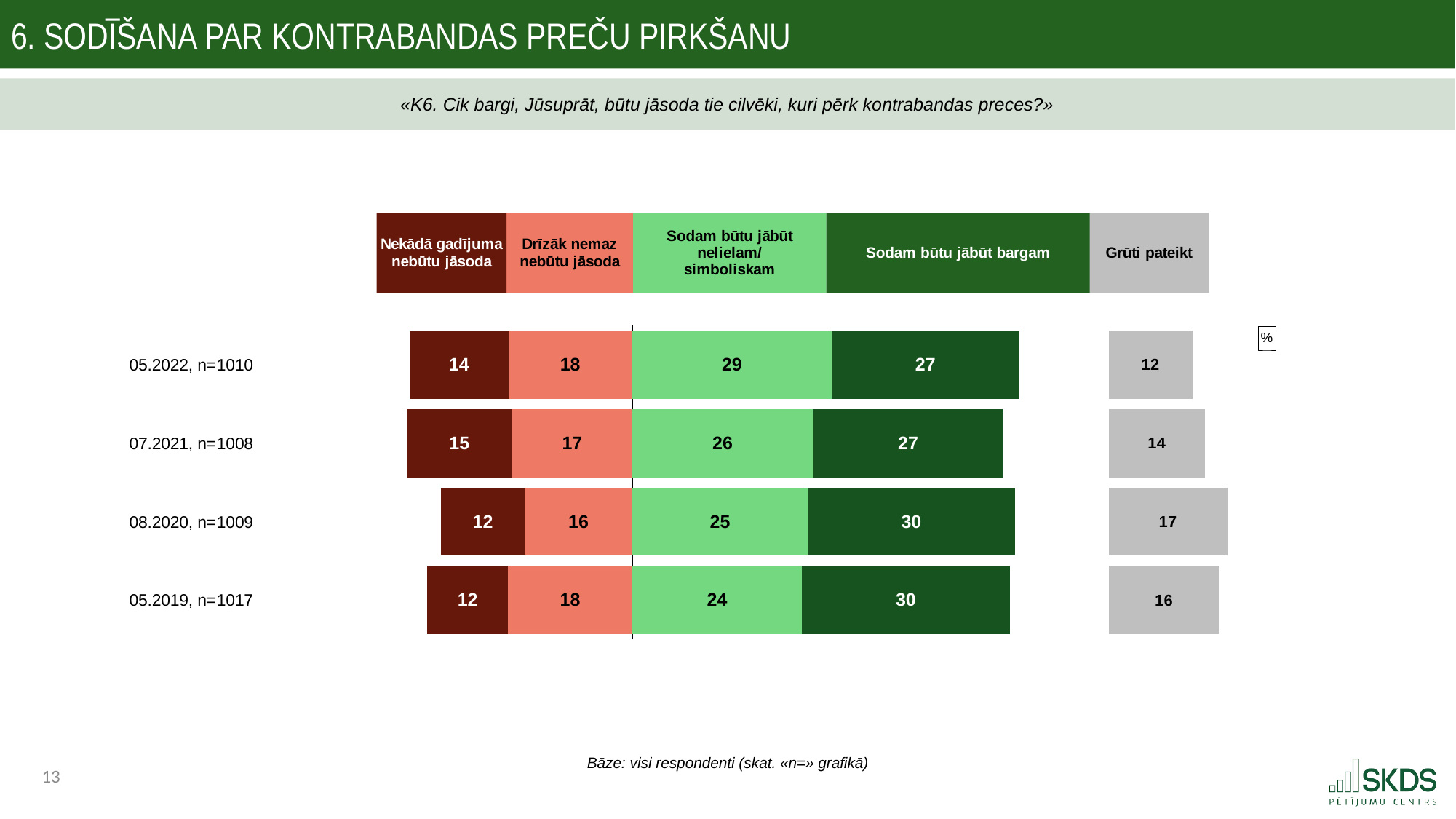
In the 07.2021, n=1008 row, which is larger: "Drīzāk nemaz nebūtu jāsoda" or "Sodam būtu jābūt nelielam/ simboliskam"? Sodam būtu jābūt nelielam/ simboliskam How many series does the legend list? 5 What is the value for "Grūti pateikt" in the 08.2020, n=1009 row? 17 What is the value for "Nekādā gadījuma nebūtu jāsoda" in the 07.2021, n=1008 row? 15 What is the value for "Sodam būtu jābūt bargam" in the 05.2019, n=1017 row? 30 How many rows (survey waves) are shown in the chart? 4 What kind of chart is shown on the slide? Stacked bar chart What is the difference between the "Sodam būtu jābūt bargam" values for 08.2020, n=1009 and 05.2022, n=1010? 3 What is the total of all segments in the 05.2019, n=1017 row? 100 Which row has the highest value for "Sodam būtu jābūt nelielam/ simboliskam"? 05.2022, n=1010 What is the value for "Sodam būtu jābūt nelielam/ simboliskam" in the 05.2022, n=1010 row? 29 Which row has the lowest value for "Grūti pateikt"? 05.2022, n=1010